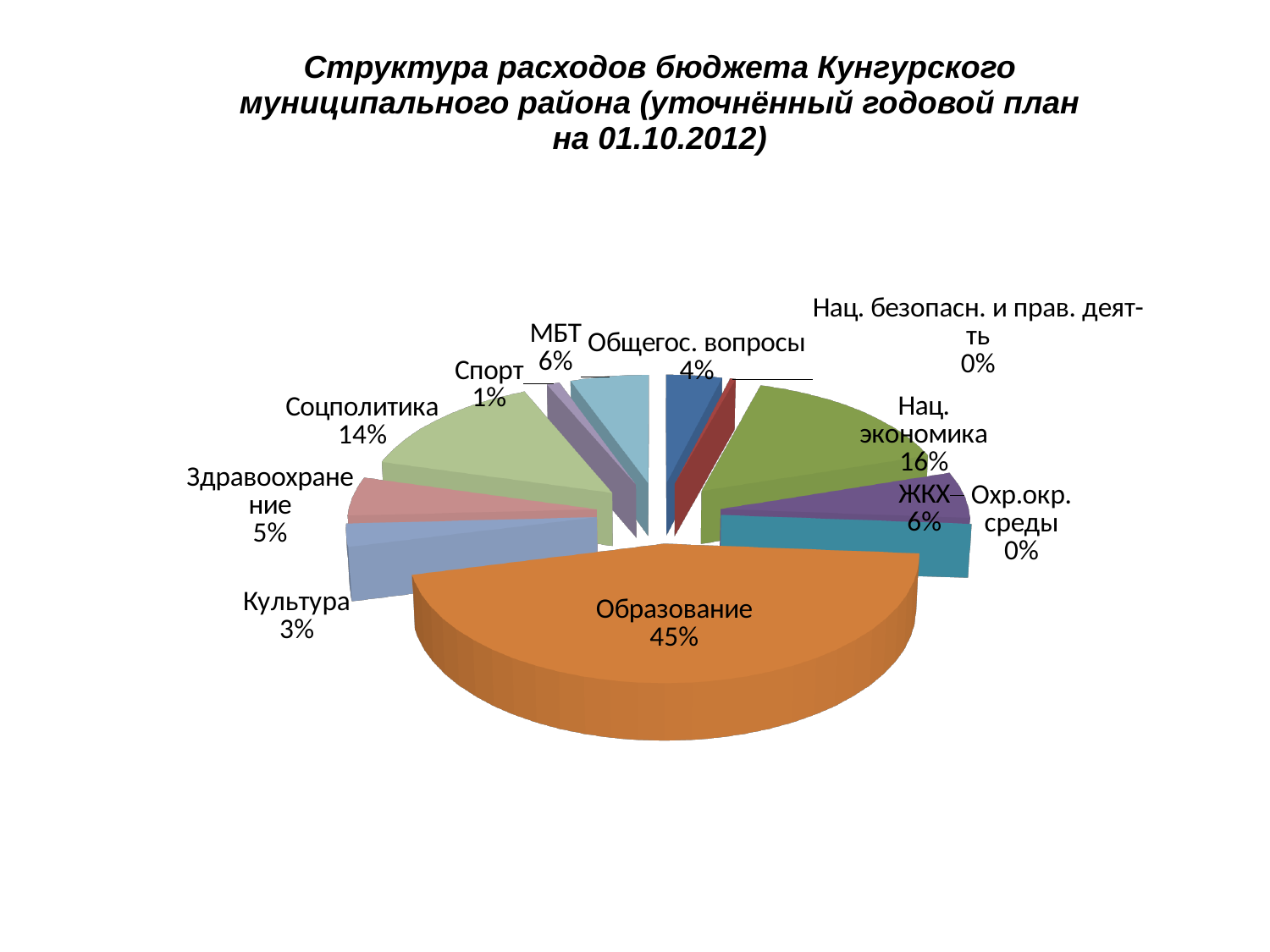
Which is larger, the share for Нац. экономика or the share for Соцполитика? Нац. экономика What date is given in the chart title for the refined annual plan? 01.10.2012 What is the difference in percentage points between the shares for ЖКХ and Спорт? 5 What is the difference in percentage points between the shares for Образование and Нац. экономика? 29 What share of the budget expenditure goes to Нац. экономика? 16% What kind of chart is shown on the slide? pie chart What share of the budget expenditure goes to Здравоохранение? 5% How many categories are shown in the pie chart? 11 What share of the budget expenditure goes to Культура? 3% What share of the budget expenditure goes to Соцполитика? 14% Which category has the largest share of the budget expenditure? Образование What share of the budget expenditure goes to Образование? 45%